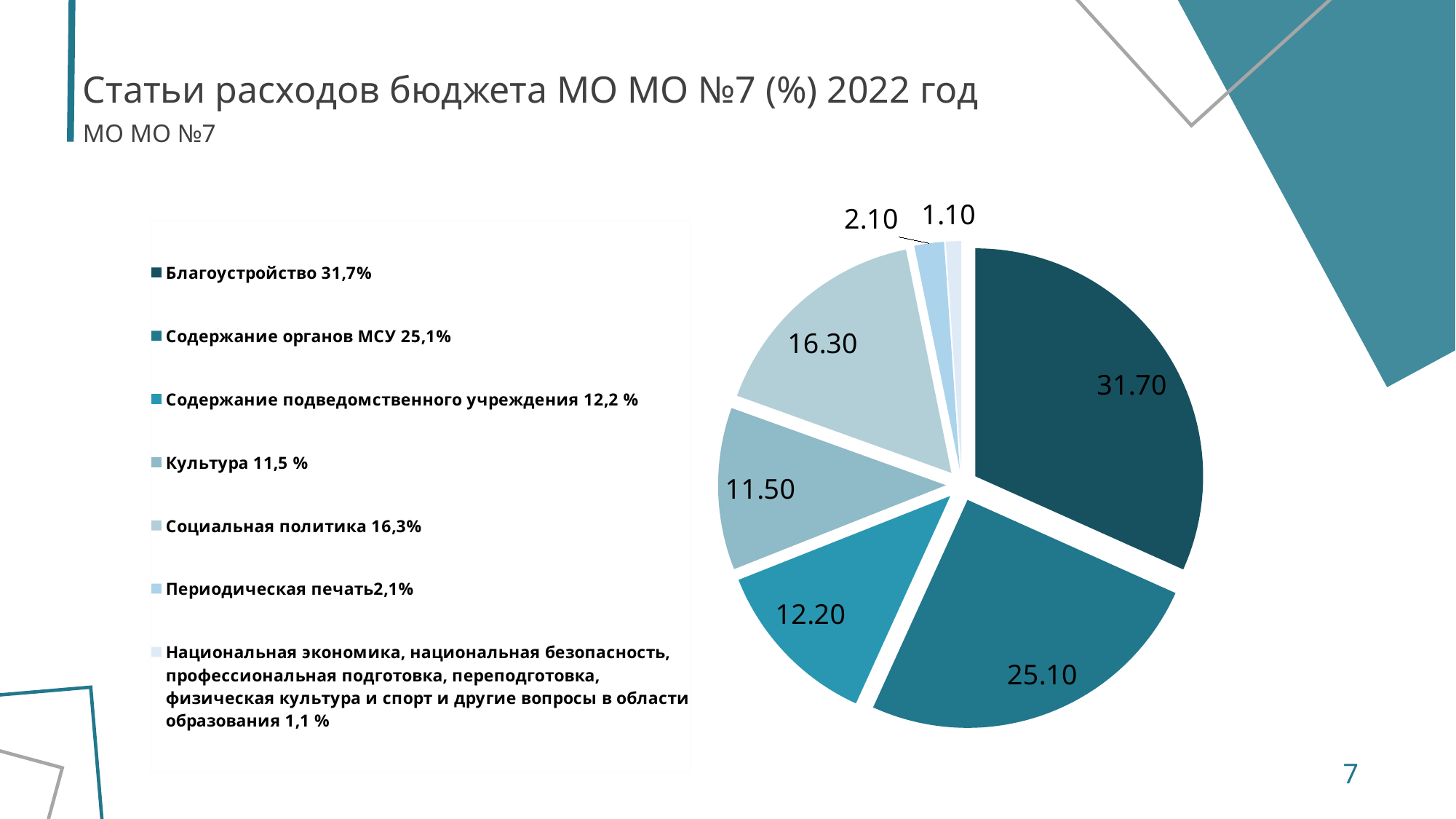
What is the data label for the Периодическая печать slice? 2.10 What is the data label for the Социальная политика slice? 16.30 What is the title of the chart on the slide? Статьи расходов бюджета МО МО №7 (%) 2022 год What kind of chart is shown on the slide? pie chart What is the difference between the Благоустройство slice and the Содержание органов МСУ slice? 6.60 How many slices does the pie chart have? 7 What is the data label for the Культура slice? 11.50 Which is larger, the Содержание подведомственного учреждения slice or the Культура slice? Содержание подведомственного учреждения Which category has the largest slice of the pie? Благоустройство Which category has the smallest slice of the pie? Национальная экономика, национальная безопасность, профессиональная подготовка, переподготовка, физическая культура и спорт и другие вопросы в области образования What is the data label for the Содержание органов МСУ slice? 25.10 What is the data label for the Благоустройство slice? 31.70